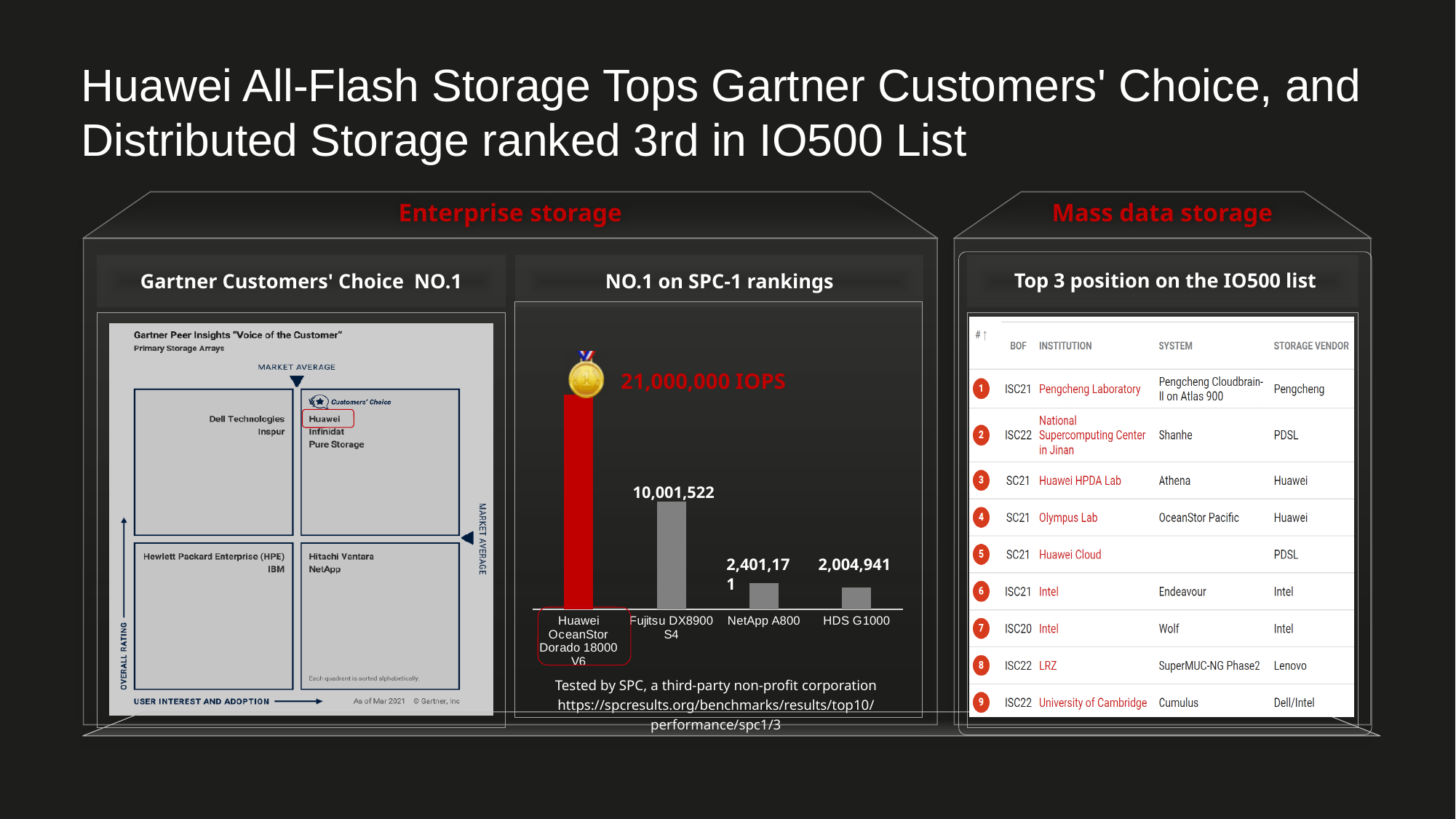
In the SPC-1 rankings bar chart, what value is shown for Huawei OceanStor Dorado 18000 V6? 21,000,000 IOPS In the SPC-1 rankings bar chart, what is the difference between the NetApp A800 value and the HDS G1000 value? 396,230 In the SPC-1 rankings bar chart, what value is shown for HDS G1000? 2,004,941 In the SPC-1 rankings bar chart, what value is shown for Fujitsu DX8900 S4? 10,001,522 In the SPC-1 rankings bar chart, which system has the highest value? Huawei OceanStor Dorado 18000 V6 In the SPC-1 rankings bar chart, do the values rise or fall from left to right? Fall In the SPC-1 rankings bar chart, which system has the lowest value? HDS G1000 What kind of chart is used for the SPC-1 rankings? Bar chart How many systems are shown as bars in the SPC-1 rankings bar chart? 4 In the SPC-1 rankings bar chart, what is the difference between the Huawei OceanStor Dorado 18000 V6 value and the Fujitsu DX8900 S4 value? 10,998,478 In the SPC-1 rankings bar chart, what value is shown for NetApp A800? 2,401,171 In the SPC-1 rankings bar chart, which has the larger value, NetApp A800 or HDS G1000? NetApp A800